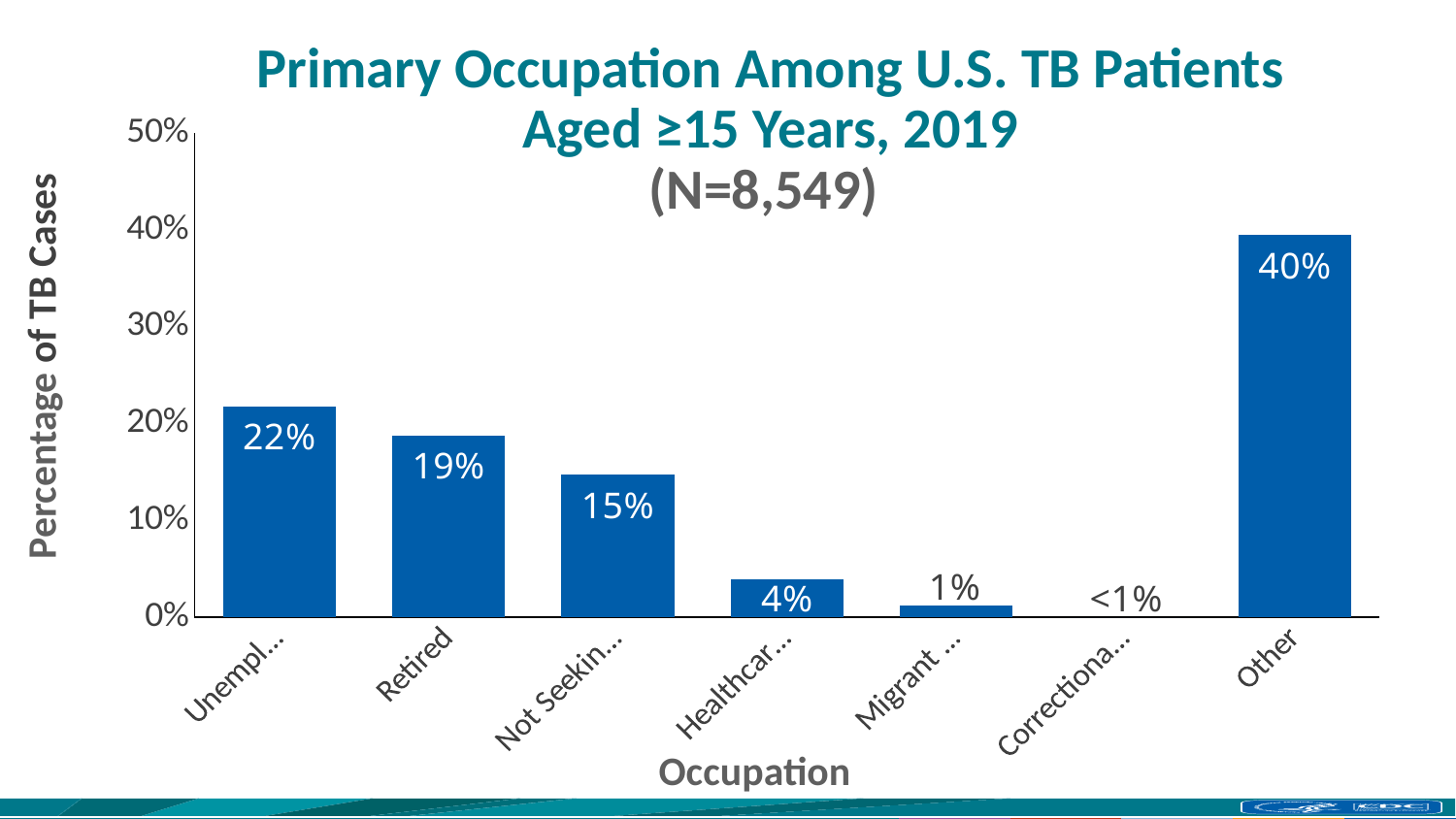
Is the value for the Retired category greater or less than 20%? less What type of chart is shown on the slide? bar chart What is the label of the y-axis? Percentage of TB Cases What percentage of TB cases is shown for the Other occupation category? 40% Which has a larger percentage of TB cases, Retired or Other? Other What is the sample size (N) given in the chart title? 8,549 How many occupation categories are plotted on the chart? 7 What is the data label on the third bar from the left? 15% What is the data label on the first (leftmost) bar of the chart? 22% What is the difference in percentage points between the Other category and the Retired category? 21 What percentage of TB cases is shown for the Retired category? 19% Which occupation category has the highest percentage of TB cases? Other